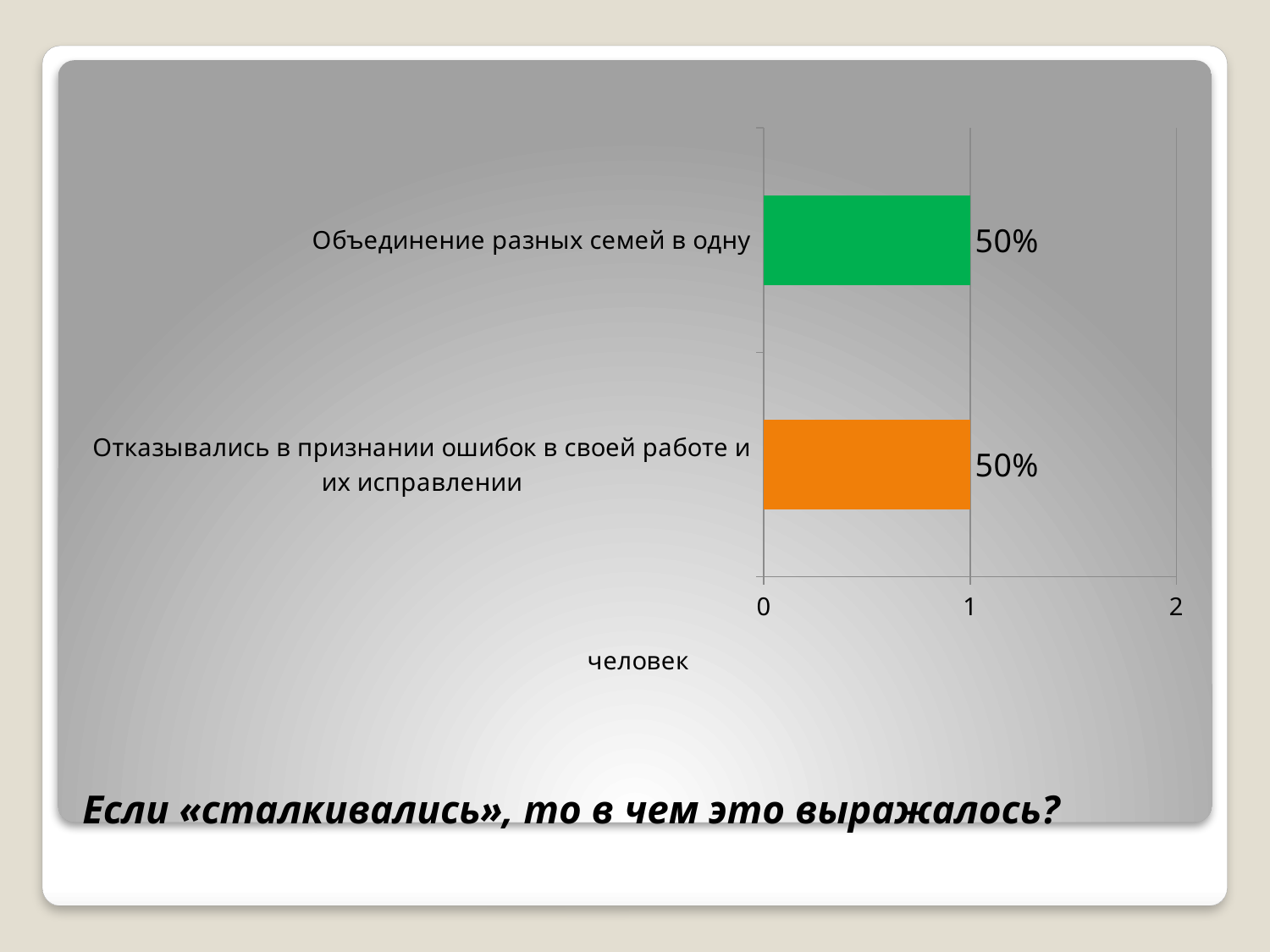
Is the value for «Отказывались в признании ошибок в своей работе и их исправлении» greater or less than 2 on the axis? less How many categories are plotted in the chart? 2 Which axis tick value does the bar for «Отказывались в признании ошибок в своей работе и их исправлении» reach? 1 Is the value for «Объединение разных семей в одну» greater or less than 2 on the axis? less What is the data label shown on the bar for «Объединение разных семей в одну»? 50% What is the data label shown on the bar for «Отказывались в признании ошибок в своей работе и их исправлении»? 50% What kind of chart is shown on the slide? bar chart What is the title of the horizontal axis? человек Which axis tick value does the bar for «Объединение разных семей в одну» reach? 1 What colour is the bar for «Объединение разных семей в одну»? green